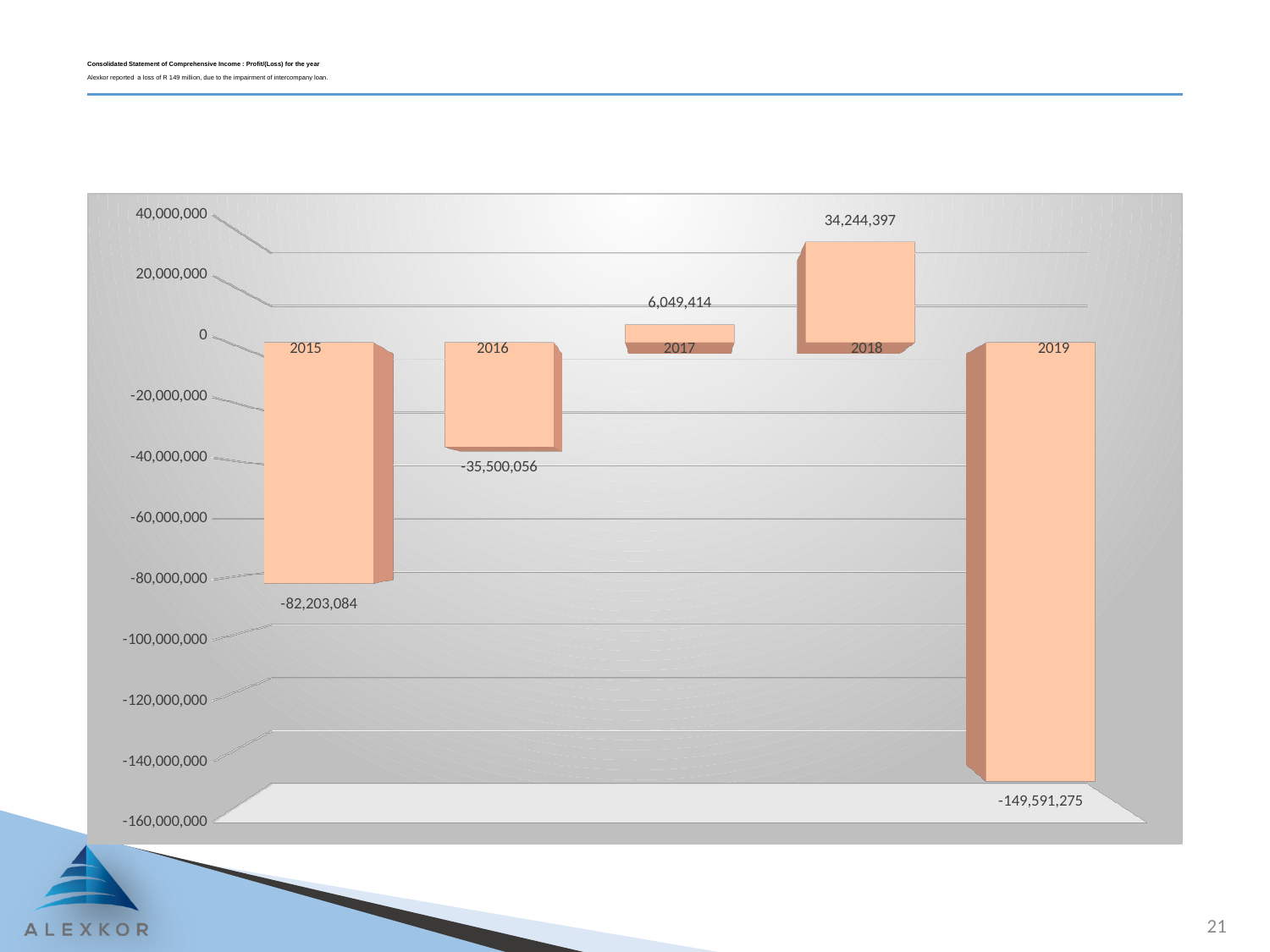
What kind of chart is shown on the slide? bar chart Which year has the lowest value? 2019 What is the difference between the values for 2018 and 2017? 28,194,983 What is the value for 2017? 6,049,414 How many years are shown on the chart? 5 What is the value for 2015? -82,203,084 What is the difference between the values for 2016 and 2015? 46,703,028 Is the value for 2019 greater or less than -140,000,000? less What is the value for 2018? 34,244,397 Which is larger, the value for 2016 or the value for 2017? 2017 What is the value for 2019? -149,591,275 Which year has the highest value? 2018